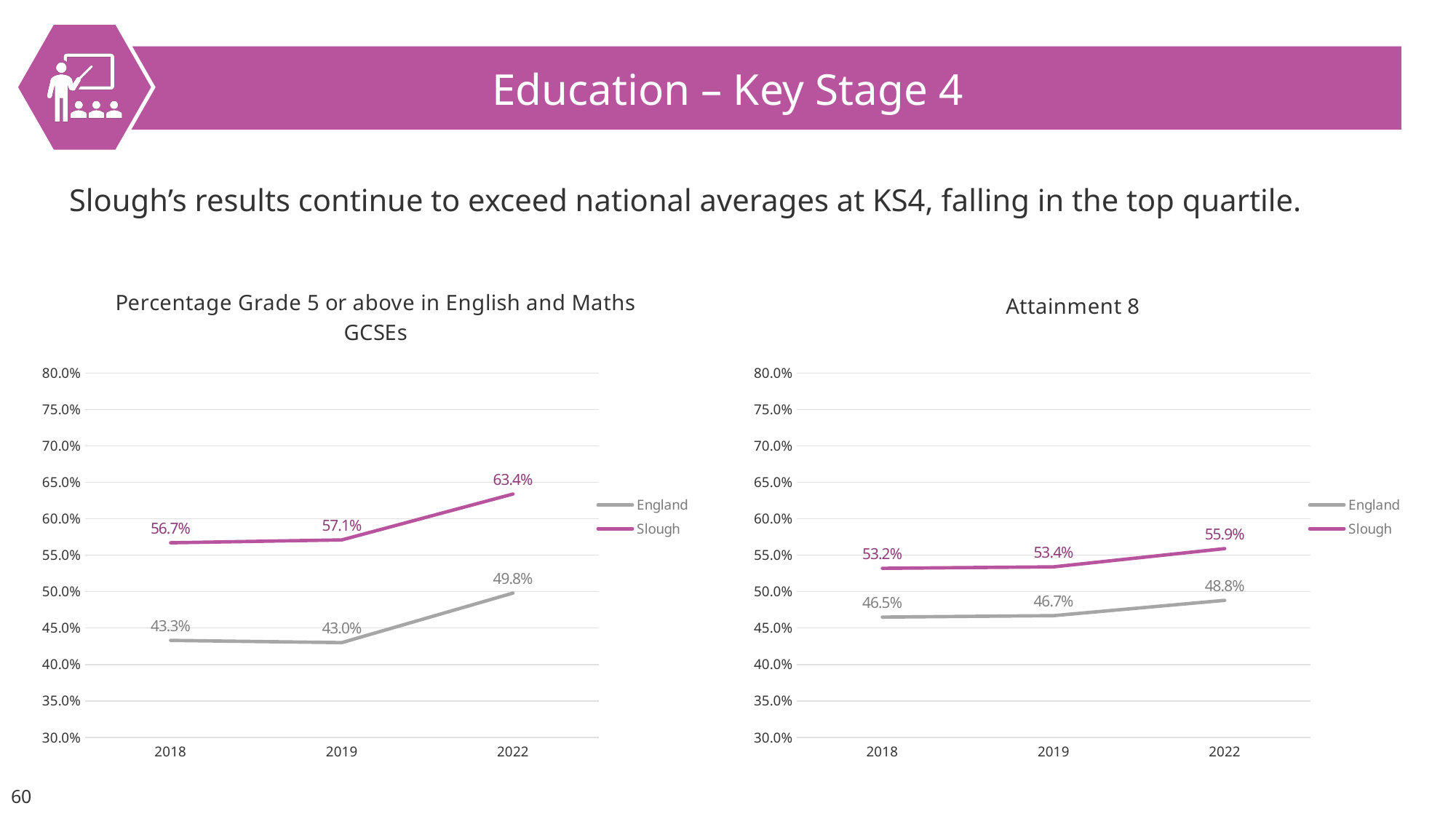
In the 'Attainment 8' chart, what is the value for England in 2022? 48.8% In the 'Percentage Grade 5 or above in English and Maths GCSEs' chart, which year has the lowest value for England? 2019 How many series does the legend of the 'Attainment 8' chart list? 2 In the 'Attainment 8' chart, what is the value for Slough in 2018? 53.2% In the 'Percentage Grade 5 or above in English and Maths GCSEs' chart, what is the value for Slough in 2022? 63.4% In the 'Attainment 8' chart, which year has the highest value for Slough? 2022 In the 'Percentage Grade 5 or above in English and Maths GCSEs' chart, does the Slough line rise or fall from 2019 to 2022? Rise In the 'Percentage Grade 5 or above in English and Maths GCSEs' chart, what is the difference between Slough and England in 2022? 13.6% In the 'Percentage Grade 5 or above in English and Maths GCSEs' chart, what is the value for England in 2019? 43.0% What kind of chart is the 'Percentage Grade 5 or above in English and Maths GCSEs' chart? Line chart In the 'Attainment 8' chart, what is the difference between Slough and England in 2018? 6.7% In the 'Attainment 8' chart, which is larger in 2019: Slough or England? Slough